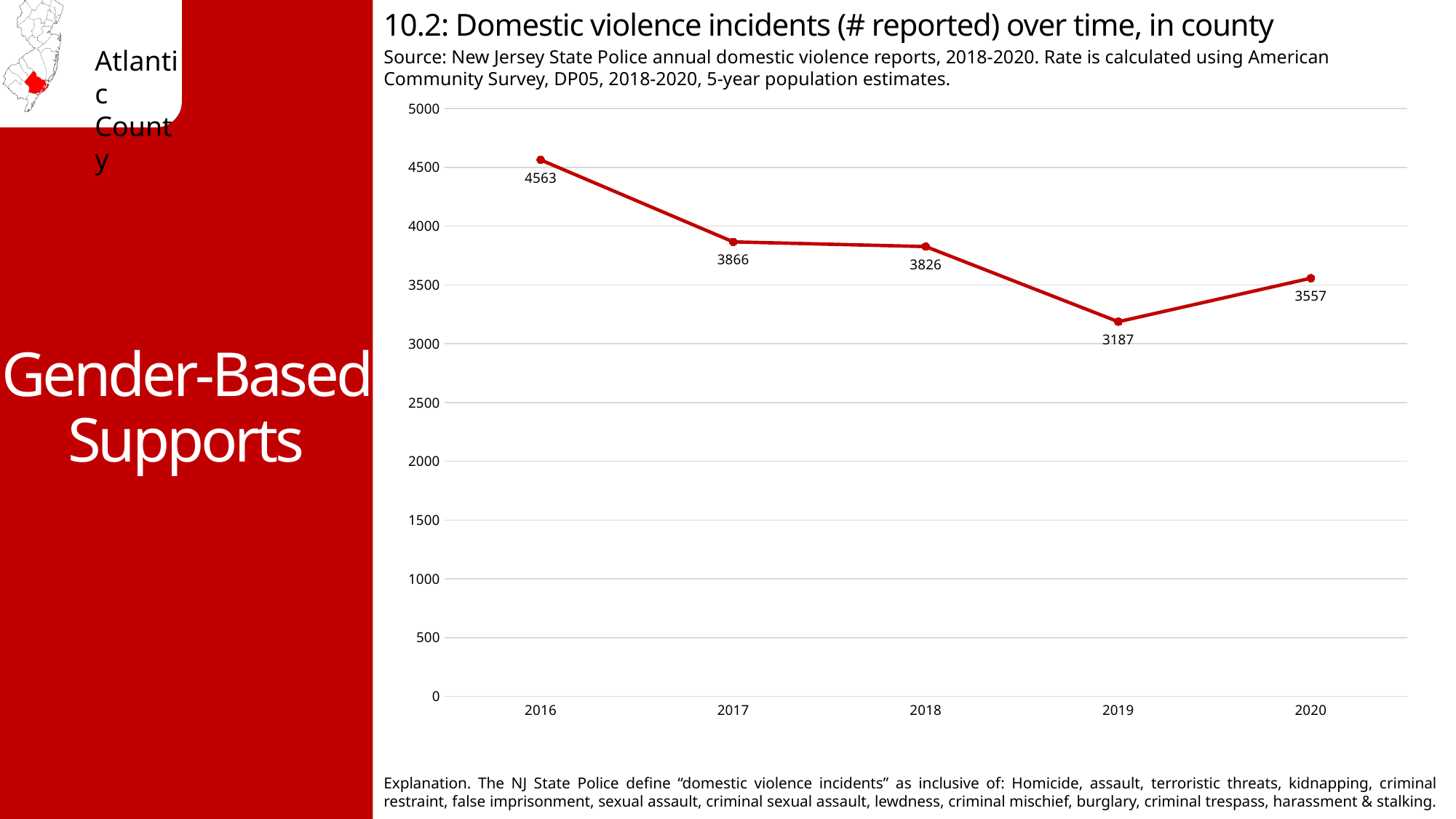
Is the value for 2018 greater or less than 3500? greater What is the difference between the 2016 value and the 2019 value? 1376 How many domestic violence incidents were reported in 2016? 4563 What kind of chart is shown on the slide? line chart Which year has the lowest number of reported domestic violence incidents? 2019 By how much did the number of incidents increase from 2019 to 2020? 370 What is the number of reported incidents for 2020? 3557 Which year has the highest number of reported domestic violence incidents? 2016 Do the values rise or fall from 2016 to 2019? fall Which year has a larger value, 2017 or 2020? 2017 How many years are plotted on the x axis? 5 What is the value plotted for 2019? 3187